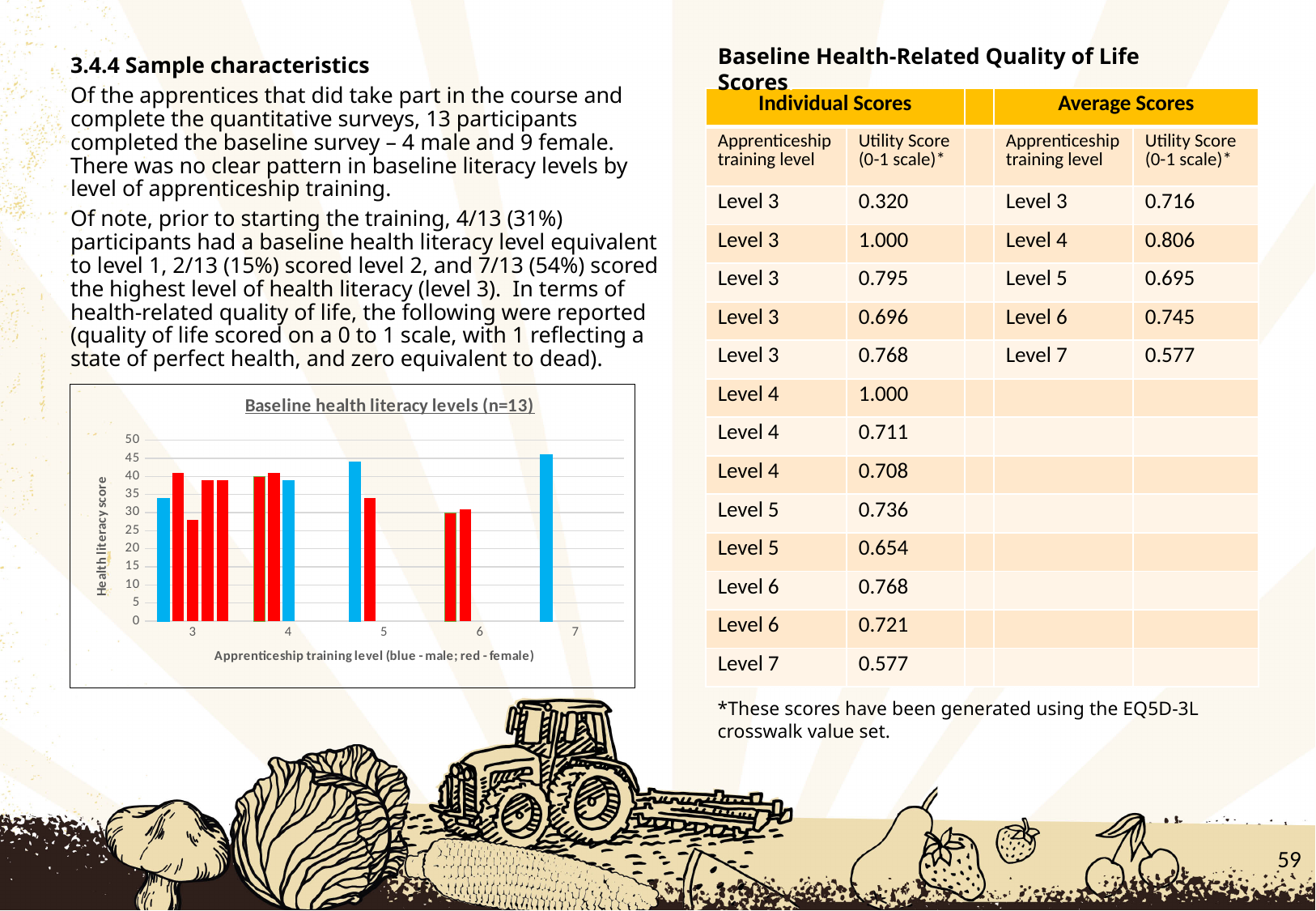
How many red (female) bars are plotted in the chart? 9 What is the title of the chart? Baseline health literacy levels (n=13) How many blue (male) bars are plotted in the chart? 4 How many apprenticeship training levels are shown on the x axis of the chart? 5 Is the value of the blue (male) bar for apprenticeship training level 5 greater or less than 40? greater Are the values of the two bars for apprenticeship training level 6 greater or less than 35? less What kind of chart is shown on the slide? bar chart What is the highest tick value shown on the y axis of the chart? 50 According to the x-axis label, which colour represents female apprentices? red Is the value of the bar for apprenticeship training level 7 greater or less than 40? greater